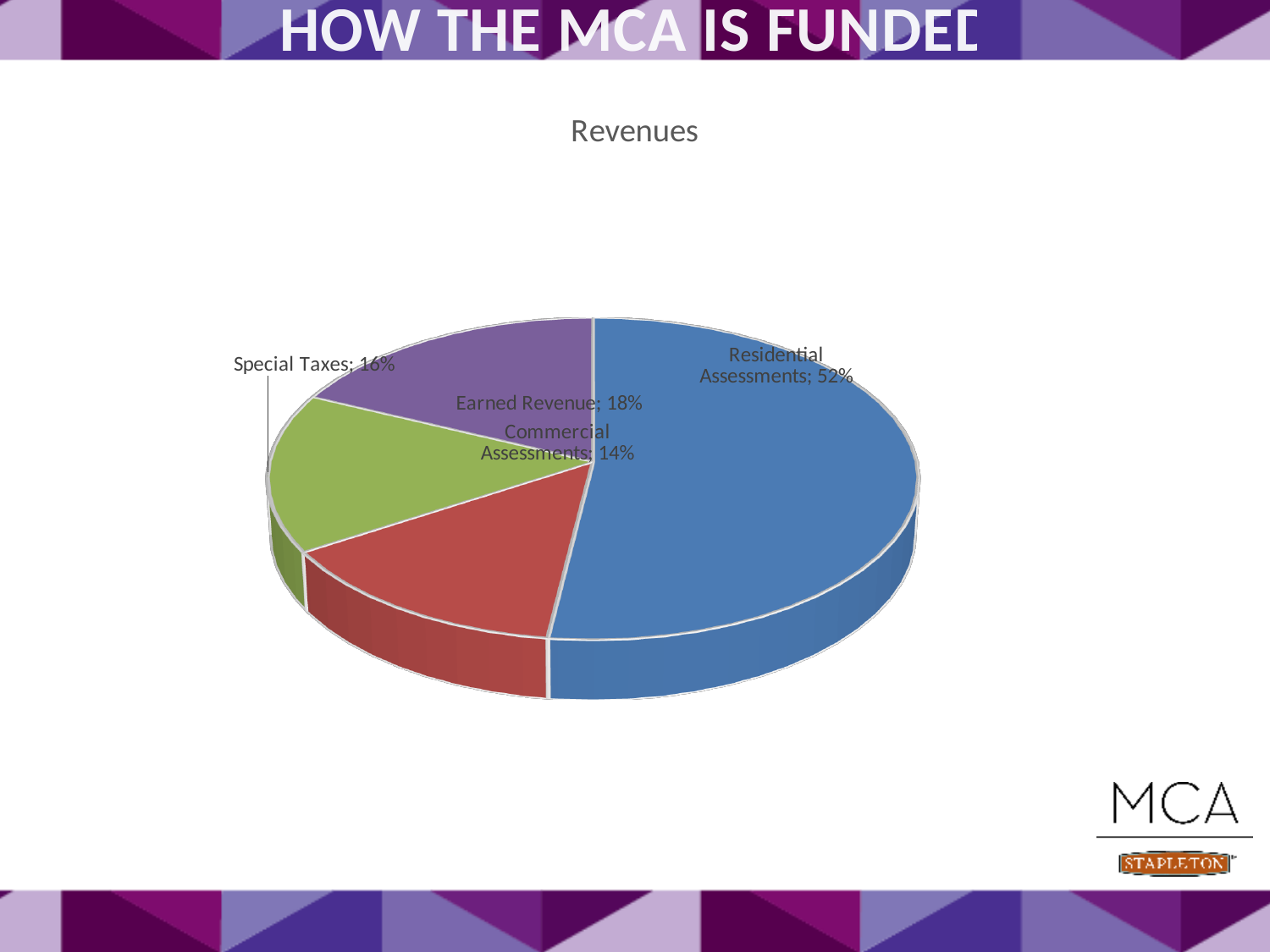
Which is larger, the share for Earned Revenue or the share for Special Taxes? Earned Revenue What share of revenues comes from Special Taxes? 16% Which revenue source has the smallest share of the pie? Commercial Assessments What colour is the Residential Assessments slice? Blue What is the difference in percentage points between Residential Assessments and Commercial Assessments? 38 How many slices does the pie chart have? 4 Which revenue source has the largest share of the pie? Residential Assessments What is the title of the chart? Revenues What type of chart is shown on the slide? Pie chart What share of revenues comes from Commercial Assessments? 14% What share of revenues comes from Earned Revenue? 18% What share of revenues comes from Residential Assessments? 52%